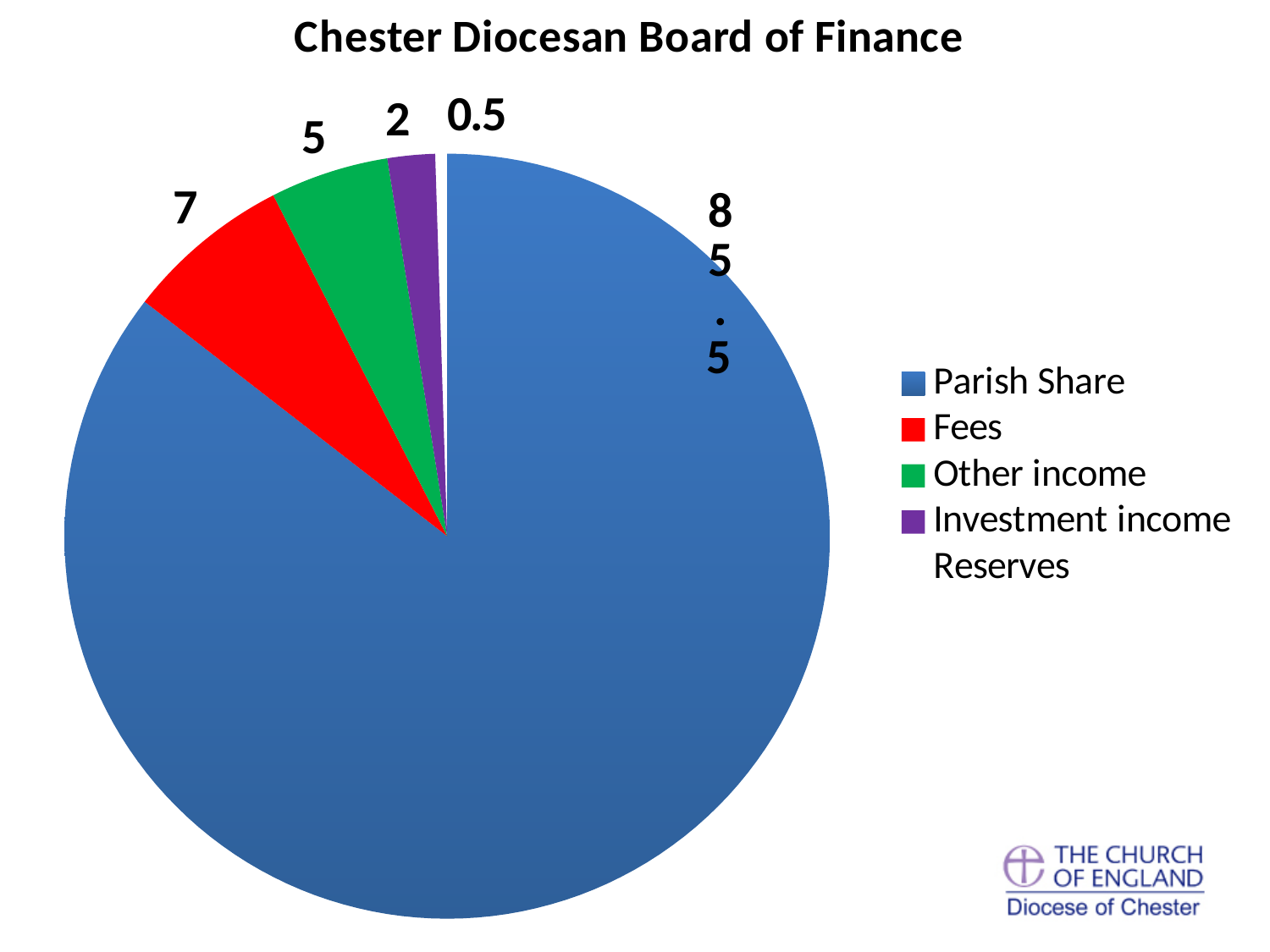
What kind of chart is shown on the slide? pie chart What is the value shown for Reserves? 0.5 How many categories does the legend list? 5 What is the value shown for Parish Share? 85.5 What is the value shown for Fees? 7 What is the difference between the values for Fees and Other income? 2 Which category has the largest slice of the pie? Parish Share Which category has the smallest slice of the pie? Reserves Which is larger, the value for Other income or the value for Investment income? Other income What is the value shown for Investment income? 2 What is the value shown for Other income? 5 What is the title of the chart? Chester Diocesan Board of Finance